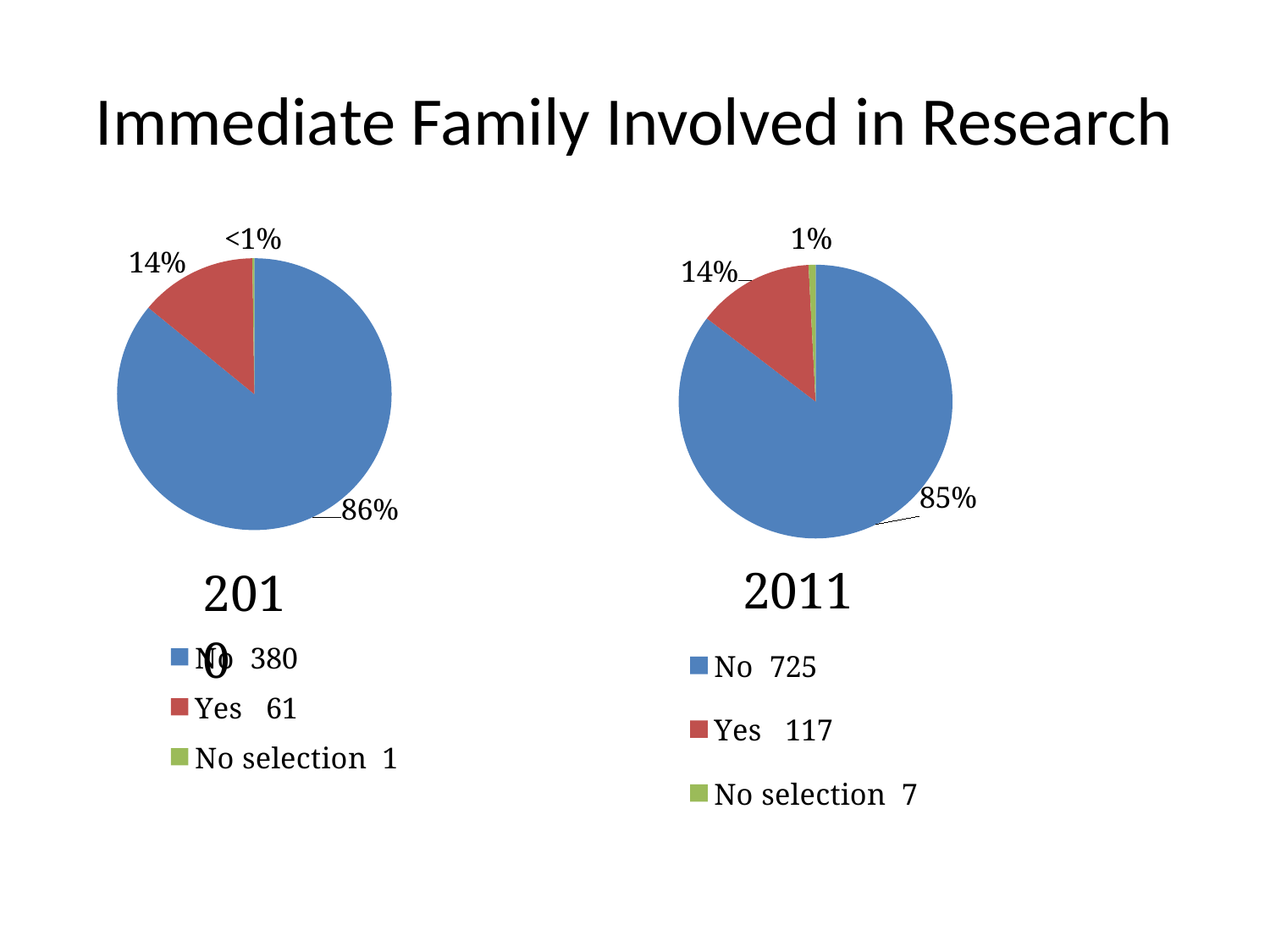
In the right pie chart (2011), what count does the legend give for 'No selection'? 7 In the left pie chart (2010), what count does the legend give for 'Yes'? 61 Which is larger: the 'Yes' count in the left pie chart (2010) or the 'Yes' count in the right pie chart (2011)? 2011 What type of charts are shown on the slide? Pie charts In the left pie chart (2010), which category has the largest slice? No In the right pie chart (2011), what percentage is shown for the 'Yes' slice? 14% What colour represents 'No selection' in both pie charts? Green In the left pie chart (2010), what percentage is shown for the 'No' slice? 86% In the right pie chart (2011), what percentage is shown for the 'No' slice? 85% How many categories does the legend of the right pie chart (2011) list? 3 In the right pie chart (2011), which category has the smallest slice? No selection What is the difference between the 'No' counts in the right pie chart (2011) and the left pie chart (2010)? 345